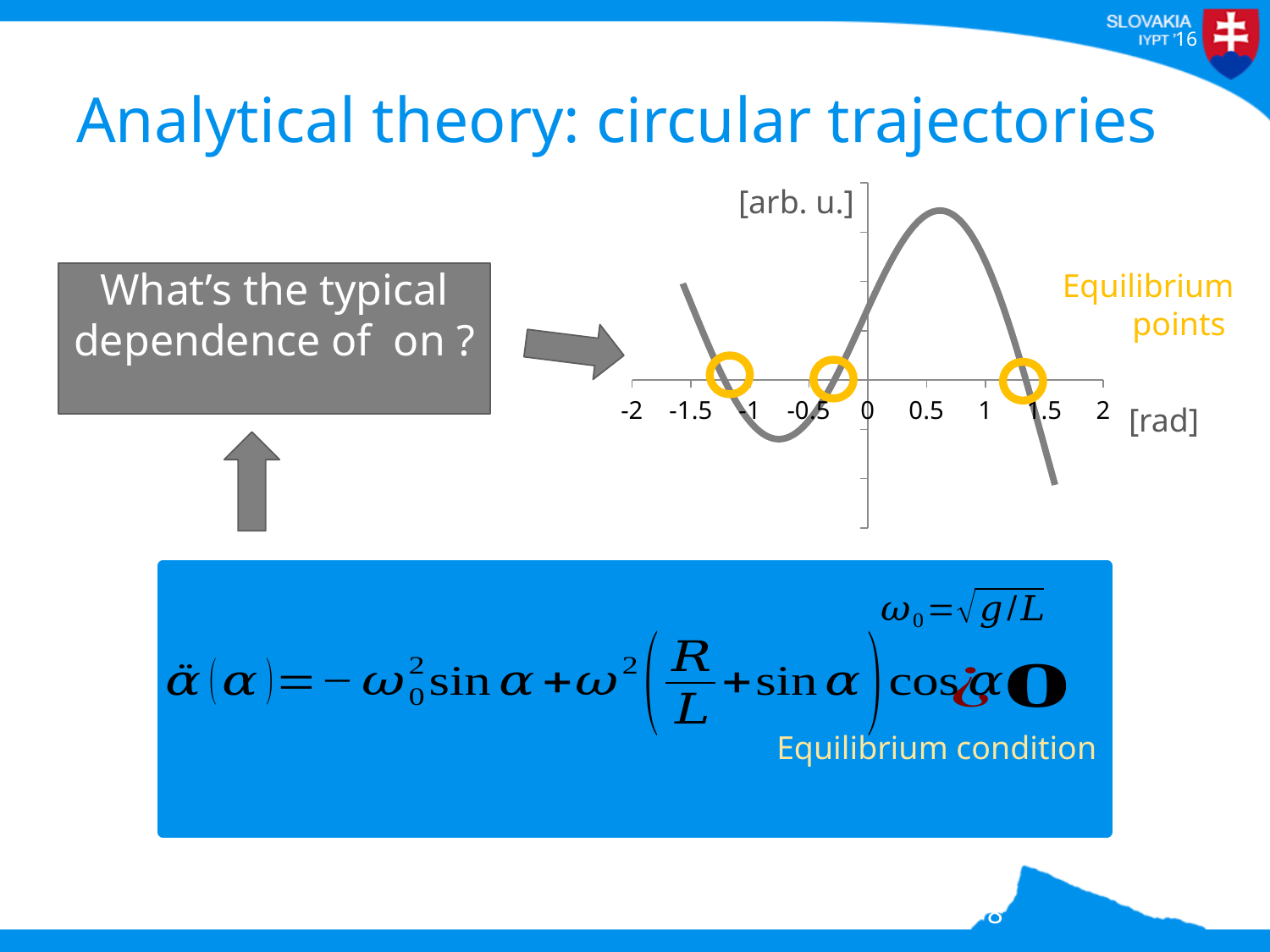
What is the lowest tick label on the x axis of the chart? -2 What kind of chart is shown on the slide? line chart How many tick labels are shown on the x axis of the chart? 9 How many equilibrium points are circled on the chart? 3 Does the curve rise or fall between x = 0 and x = 0.5? rise Is the value of the curve at x = 0.5 greater or less than 0? greater Is the value of the curve at x = -1 greater or less than 0? less Is the value of the curve at x = 1.5 greater or less than 0? less Does the curve rise or fall between x = 1 and x = 1.5? fall What do the orange circles on the chart mark? Equilibrium points What is the highest tick label on the x axis of the chart? 2